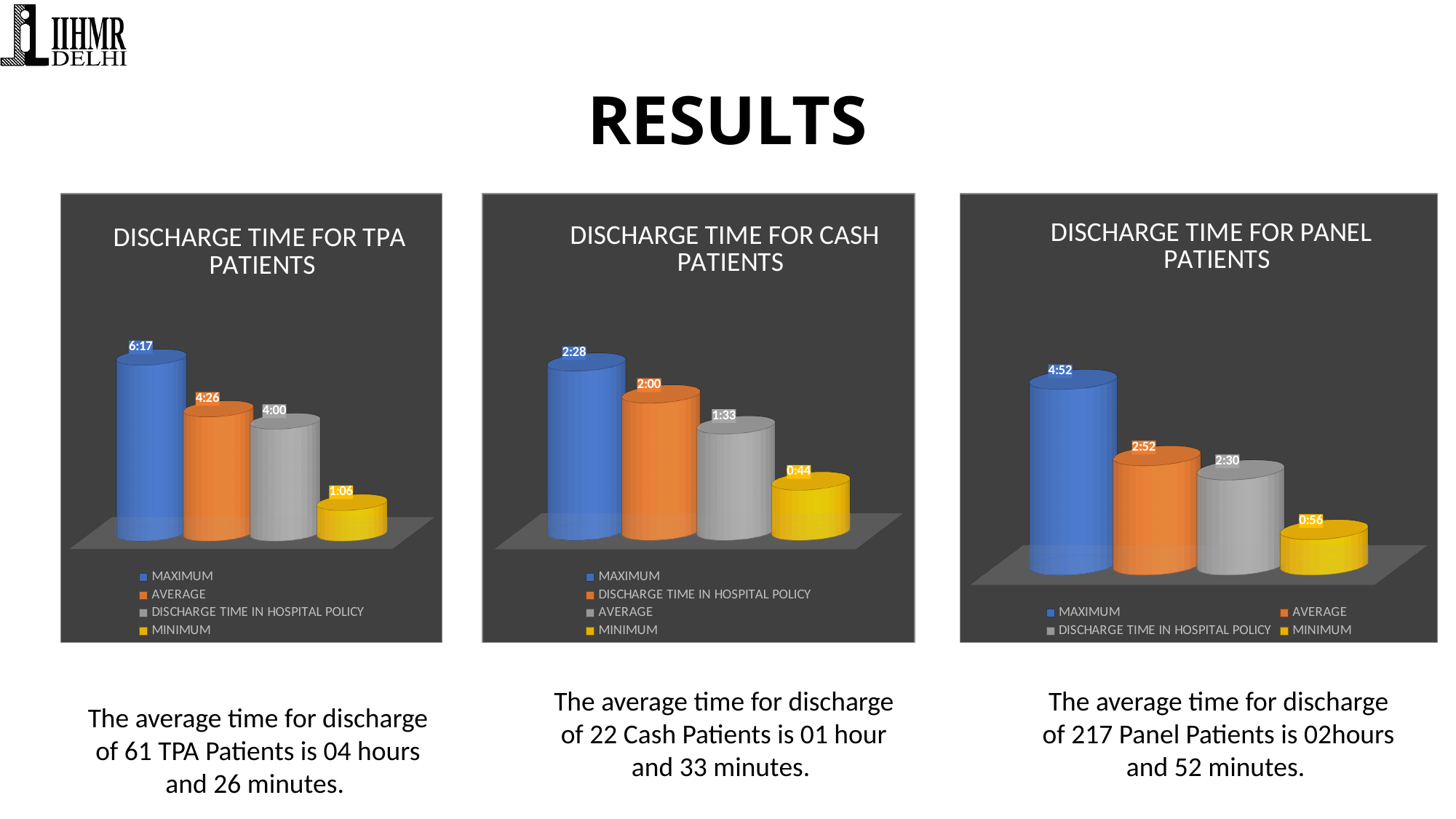
In the Discharge Time for TPA Patients chart, what is the average discharge time? 4:26 In the Discharge Time for Cash Patients chart, what is the average discharge time? 1:33 In the Discharge Time for TPA Patients chart, what is the discharge time in hospital policy? 4:00 How many bars are shown in the Discharge Time for TPA Patients chart? 4 In the Discharge Time for Panel Patients chart, which colour represents MAXIMUM? Blue In the Discharge Time for TPA Patients chart, what is the maximum discharge time? 6:17 In the Discharge Time for Cash Patients chart, which is larger: the discharge time in hospital policy or the average discharge time? Discharge time in hospital policy What type of chart is the Discharge Time for Cash Patients chart? Bar chart In the Discharge Time for Cash Patients chart, what is the minimum discharge time? 0:44 In the Discharge Time for Panel Patients chart, which category has the lowest value? MINIMUM In the Discharge Time for Panel Patients chart, what is the minimum discharge time? 0:56 In the Discharge Time for Panel Patients chart, what is the maximum discharge time? 4:52